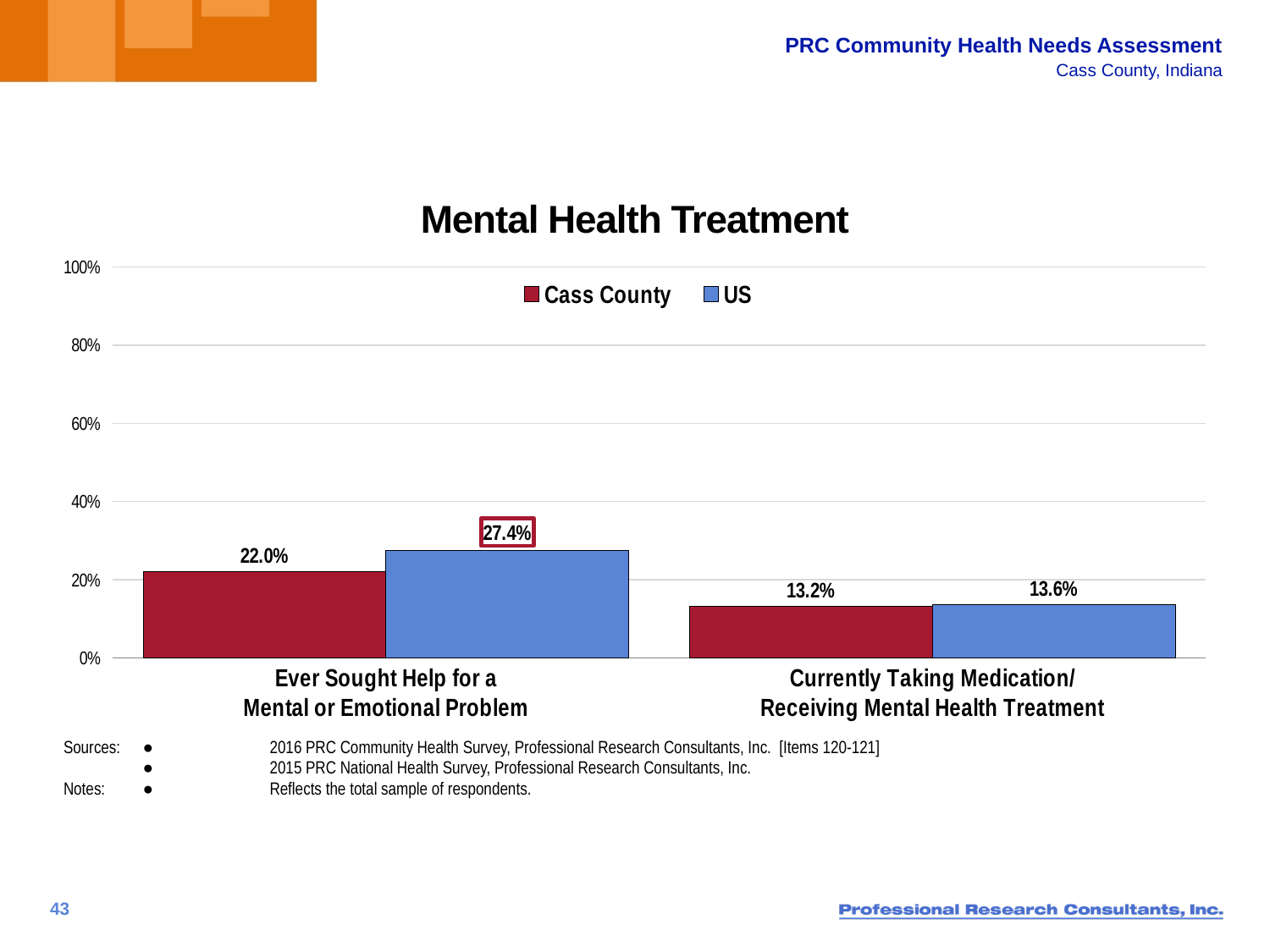
What kind of chart is shown on the slide? bar chart Which bar has the highest value on the chart? US, Ever Sought Help for a Mental or Emotional Problem What is the US value for "Ever Sought Help for a Mental or Emotional Problem"? 27.4% How many categories are shown on the x axis? 2 What is the difference between the US and Cass County values for "Ever Sought Help for a Mental or Emotional Problem"? 5.4% Is the Cass County value for "Ever Sought Help for a Mental or Emotional Problem" greater or less than 40%? less What is the Cass County value for "Ever Sought Help for a Mental or Emotional Problem"? 22.0% For "Ever Sought Help for a Mental or Emotional Problem", which is larger: Cass County or US? US How many series does the legend list? 2 What is the title of the chart? Mental Health Treatment What is the Cass County value for "Currently Taking Medication/Receiving Mental Health Treatment"? 13.2% What is the US value for "Currently Taking Medication/Receiving Mental Health Treatment"? 13.6%